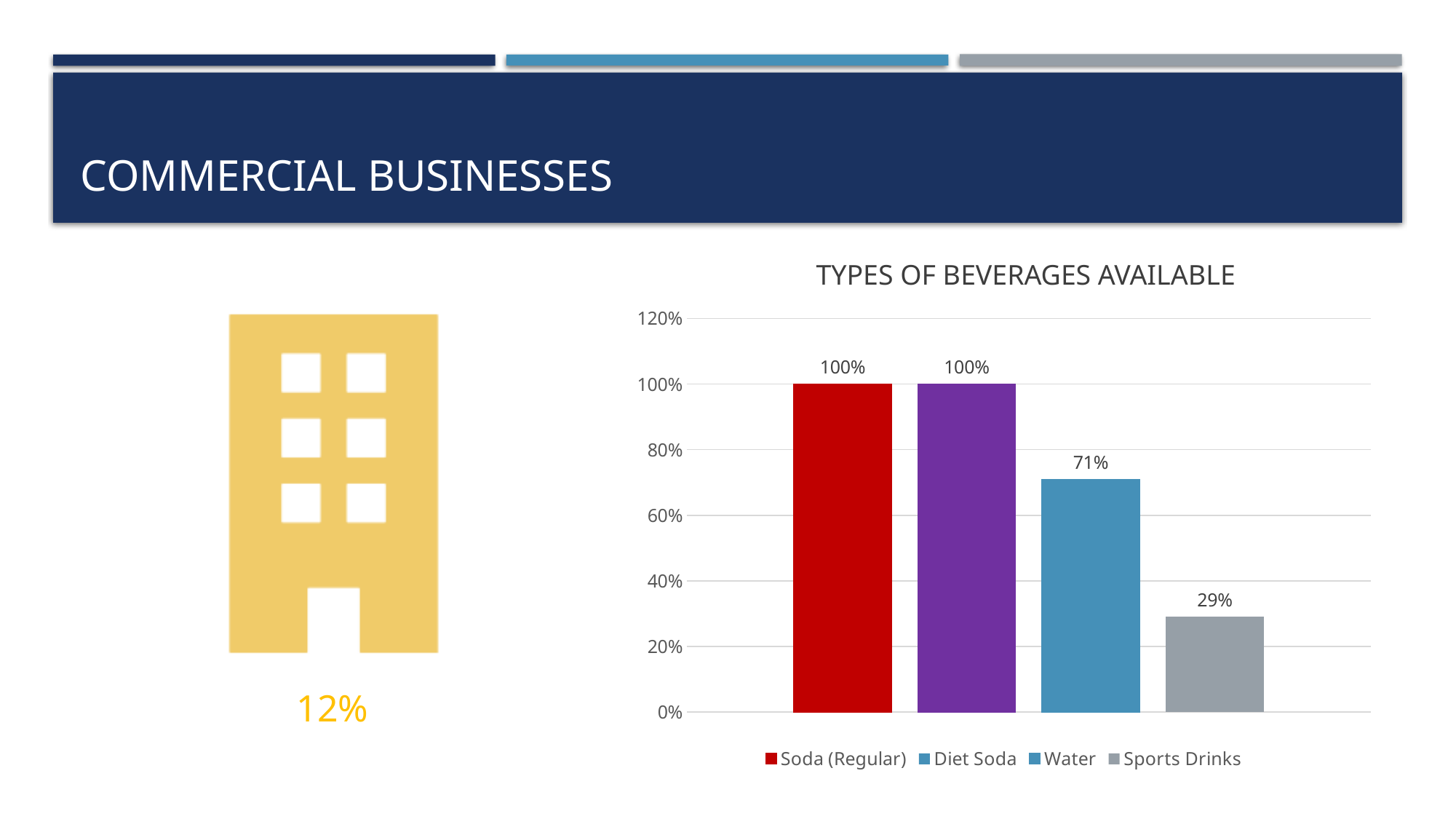
In the Types of Beverages Available chart, what is the value for Sports Drinks? 29% In the Types of Beverages Available chart, what is the value for Diet Soda? 100% In the Types of Beverages Available chart, which beverage type has the lowest value? Sports Drinks In the Types of Beverages Available chart, what is the difference between the values for Water and Sports Drinks? 42% What kind of chart is the Types of Beverages Available chart? Bar chart In the Types of Beverages Available chart, what is the value for Water? 71% In the Types of Beverages Available chart, what is the value for Soda (Regular)? 100% In the Types of Beverages Available chart, what is the difference between the values for Soda (Regular) and Water? 29% What is the title of the chart on the slide? TYPES OF BEVERAGES AVAILABLE In the Types of Beverages Available chart, is the value for Water greater or less than 80%? less How many beverage categories are shown in the Types of Beverages Available chart? 4 In the Types of Beverages Available chart, which is larger, the value for Water or the value for Sports Drinks? Water